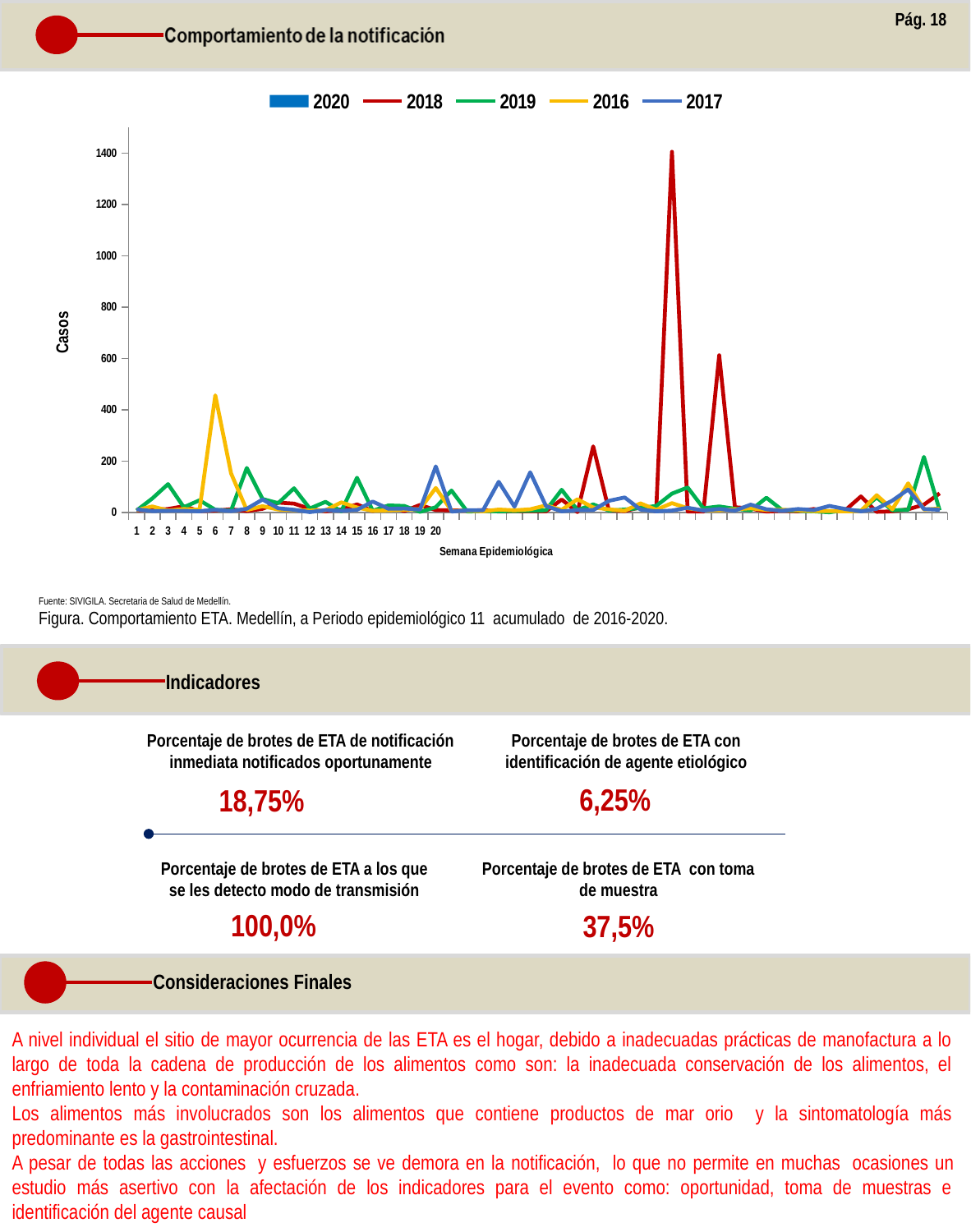
Is the highest peak of the 2018 series greater or less than 1200? greater How many series does the chart legend list? 5 Which series has the higher peak, 2018 or 2016? 2018 Which series reaches the highest peak on the chart? 2018 What kind of chart is shown on the slide? combination bar and line chart Which series has the higher peak at week 6, 2016 or 2019? 2016 Which years are listed in the chart legend? 2020, 2018, 2019, 2016, 2017 What is the highest value shown on the vertical axis of the chart? 1400 Is the peak of the 2016 series at week 6 greater or less than 400? greater Is the peak of the 2019 series at week 8 greater or less than 200? less What is the title of the vertical axis of the chart? Casos